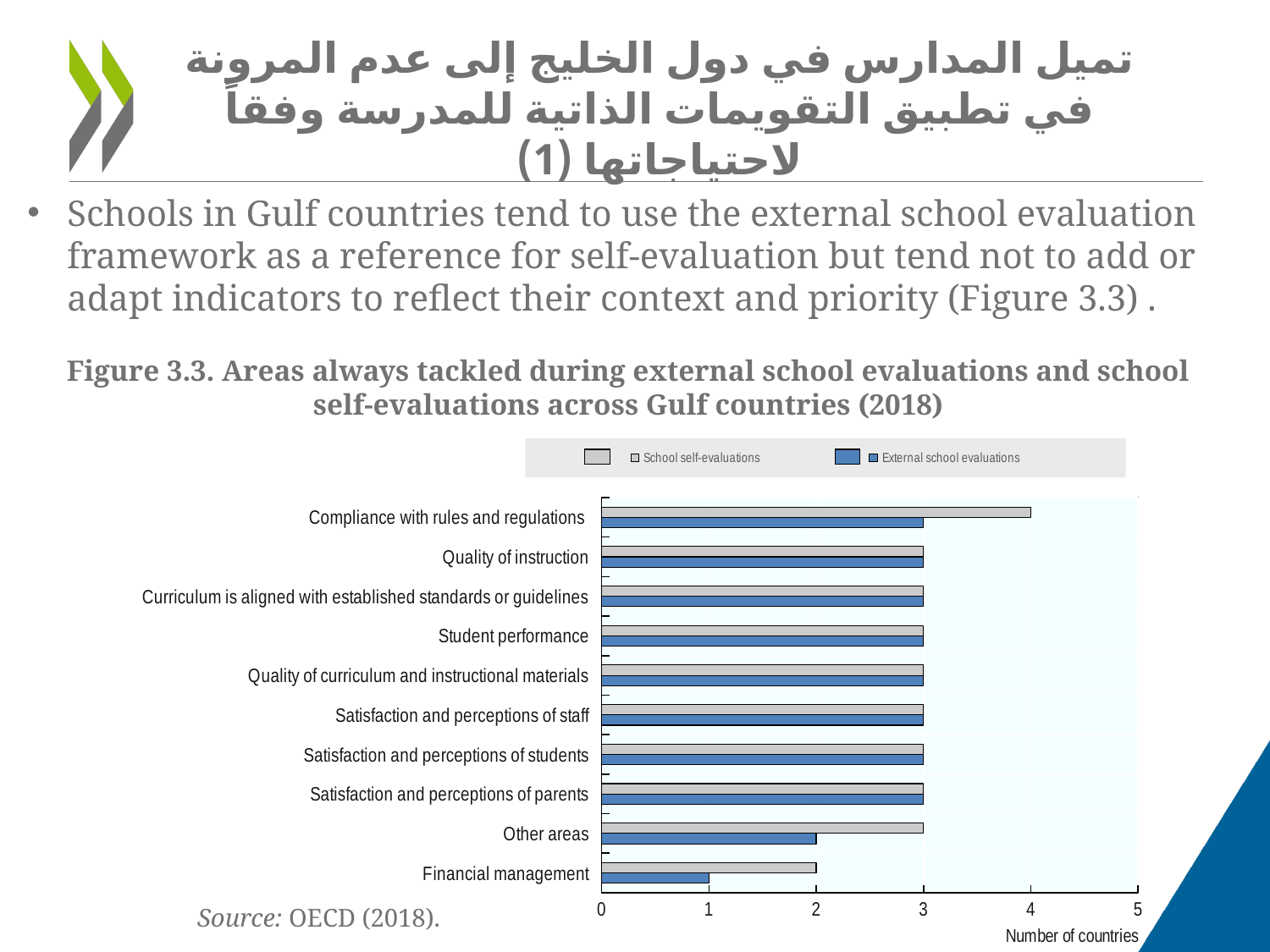
What type of chart is shown in Figure 3.3? bar chart How many series does the legend of Figure 3.3 list? 2 In Figure 3.3, what is the number of countries for School self-evaluations for Compliance with rules and regulations? 4 In Figure 3.3, what is the number of countries for School self-evaluations for Financial management? 2 How many areas (categories) are plotted in Figure 3.3? 10 In Figure 3.3, which area has the highest value for School self-evaluations? Compliance with rules and regulations In Figure 3.3, which is larger for Other areas: School self-evaluations or External school evaluations? School self-evaluations In Figure 3.3, what is the number of countries for External school evaluations for Financial management? 1 What is the label of the horizontal axis in Figure 3.3? Number of countries In Figure 3.3, which area has the lowest value for External school evaluations? Financial management In Figure 3.3, what is the difference between School self-evaluations and External school evaluations for Compliance with rules and regulations? 1 In Figure 3.3, what is the number of countries for External school evaluations for Other areas? 2